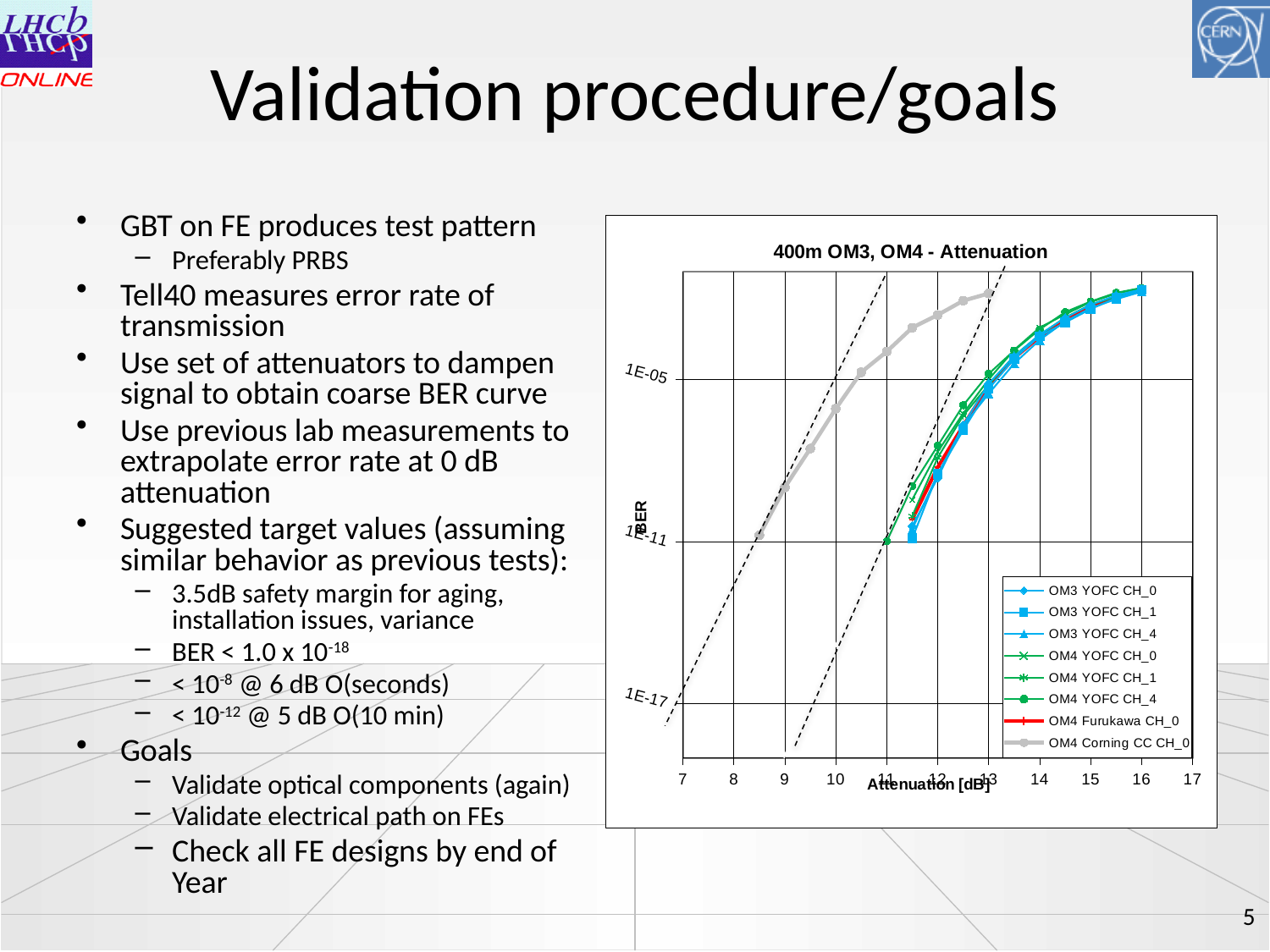
At an attenuation of 11 dB, is the BER for OM4 YOFC CH_4 greater or less than 1E-05? less What is the lowest attenuation value shown on the x axis of the chart? 7 What is the label of the y axis of the chart? BER At an attenuation of 9 dB, is the BER for OM4 Corning CC CH_0 greater or less than 1E-05? less How many series does the chart legend list? 8 What is the label of the x axis of the chart? Attenuation [dB] Which series in the chart lies furthest to the left, reaching high BER at the lowest attenuation values? OM4 Corning CC CH_0 What kind of chart is shown on the slide? line chart What is the title of the chart? 400m OM3, OM4 - Attenuation What is the highest attenuation value shown on the x axis of the chart? 17 At an attenuation of 16 dB, is the BER for OM3 YOFC CH_1 greater or less than 1E-05? greater Does the BER rise or fall as attenuation increases along the x axis? rise